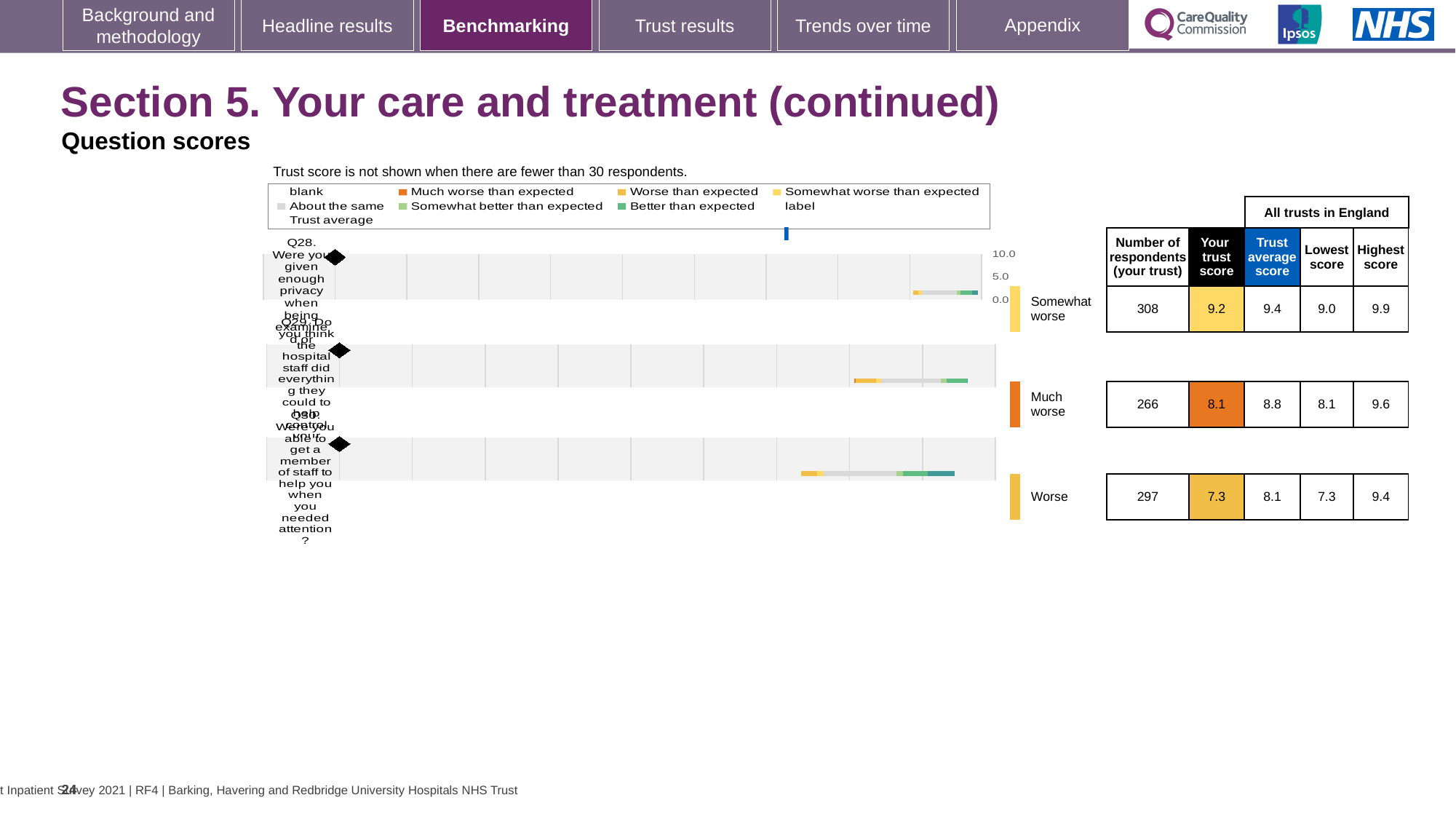
What is the highest score among all trusts in England for Q29? 9.6 What is the trust score for Q29 (Do you think the hospital staff did everything they could to help control your pain?)? 8.1 What is the difference between the trust score and the trust average score for Q29? 0.7 Is the trust score for Q28 greater or less than the trust average score for Q28? less What is the trust score for Q28 (Were you given enough privacy when being examined or treated?)? 9.2 Which of the three questions shown has the lowest trust score? Q30 What is the trust average score across all trusts in England for Q30? 8.1 What is the trust score for Q30 (Were you able to get a member of staff to help you when you needed attention?)? 7.3 What benchmark category is Q29 rated as? Much worse How many questions are plotted on this slide? 3 Which of the three questions shown has the highest trust score? Q28 How many respondents answered Q28 at this trust? 308